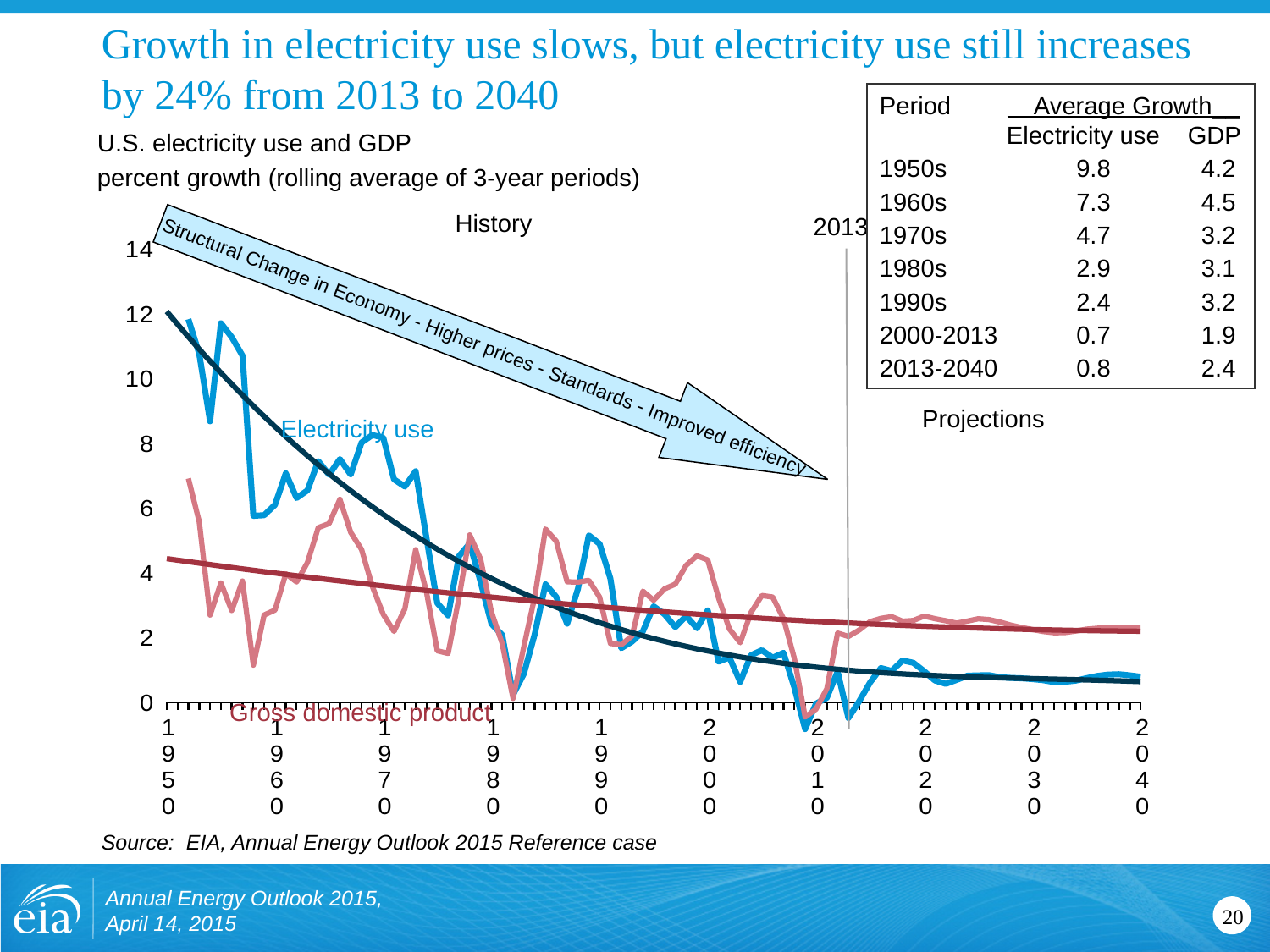
Is the electricity use growth value at the start of the 1950s greater or less than 10? greater What is the subtitle describing the chart's measure? U.S. electricity use and GDP percent growth (rolling average of 3-year periods) According to the table, what is the average electricity use growth for 2013-2040? 0.8 What kind of chart is shown on the slide? line chart Which series has the higher growth value in 2040, electricity use or gross domestic product? Gross domestic product Does electricity use growth generally rise or fall from 1950 to 2040? fall How many data series are plotted in the chart? 2 What are the two series plotted in the chart? Electricity use and Gross domestic product Is the electricity use growth value in 2040 greater or less than 2? less Is the gross domestic product growth value in 2040 greater or less than 4? less Which series has the higher growth value in the early 1950s, electricity use or gross domestic product? Electricity use In which year does the vertical line separating History from Projections fall? 2013